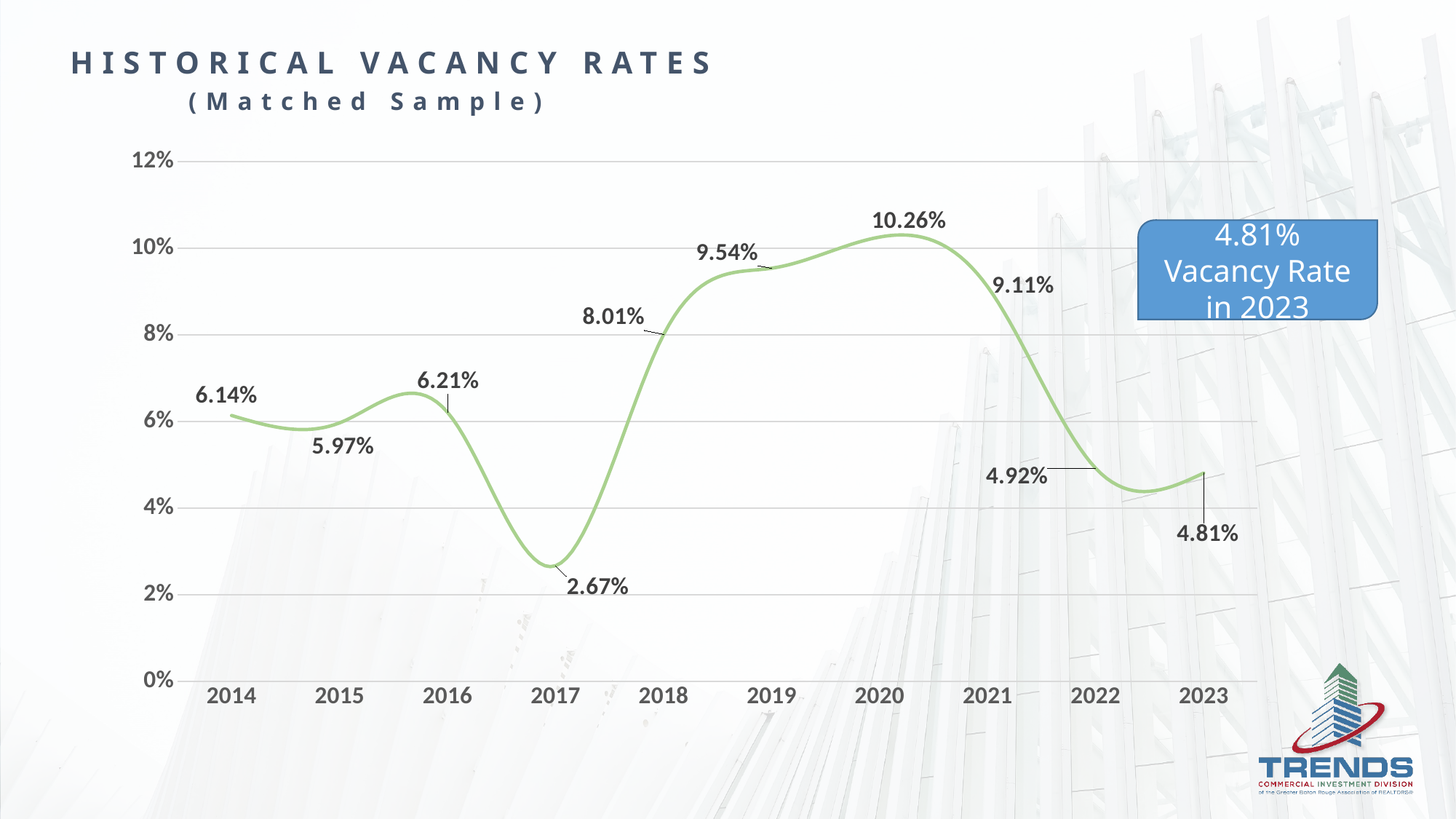
Which year has the highest vacancy rate? 2020 Which year has the lowest vacancy rate? 2017 What is the vacancy rate for 2020? 10.26% What is the vacancy rate for 2017? 2.67% What is the difference between the vacancy rates in 2018 and 2017? 5.34% Does the vacancy rate rise or fall from 2020 to 2023? fall Is the vacancy rate for 2022 greater or less than 6%? less What is the difference between the vacancy rates in 2020 and 2023? 5.45% How many years are shown on the x axis? 10 What is the vacancy rate for 2023? 4.81% Which year has a higher vacancy rate, 2019 or 2021? 2019 What kind of chart is shown on the slide? line chart